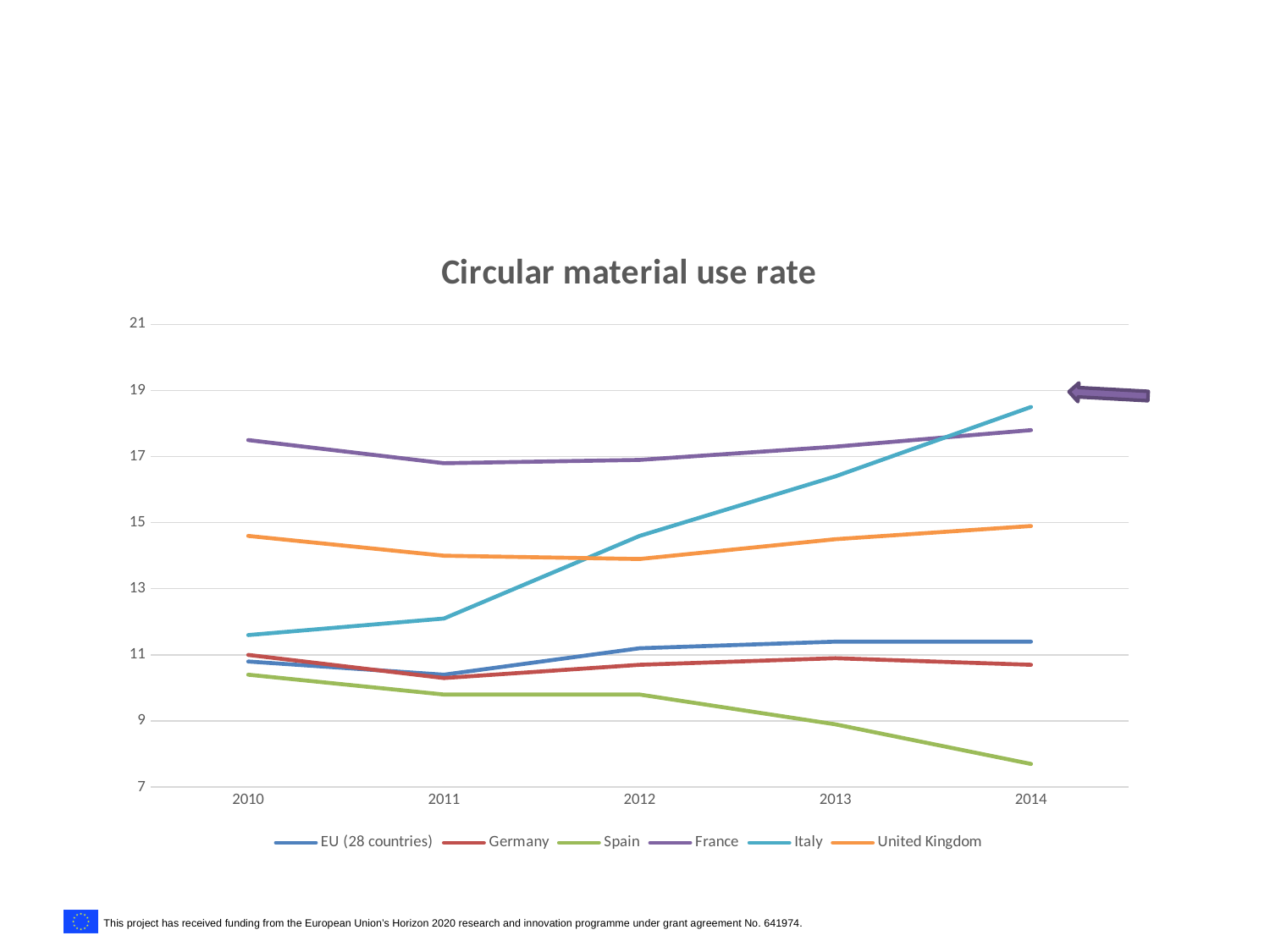
What kind of chart is shown on the slide? line chart Does the value for Italy rise or fall from 2010 to 2014? rise Which series has the highest value in 2014? Italy Is the value for Italy in 2014 greater or less than 17? greater In 2010, which is larger: the value for France or the value for United Kingdom? France How many series does the legend list? 6 Is the value for United Kingdom in 2012 greater or less than 15? less Does the value for Spain rise or fall from 2012 to 2014? fall How many years are plotted along the x axis? 5 Which series has the lowest value in 2014? Spain What is the title of the chart? Circular material use rate Is the value for Spain in 2014 greater or less than 9? less